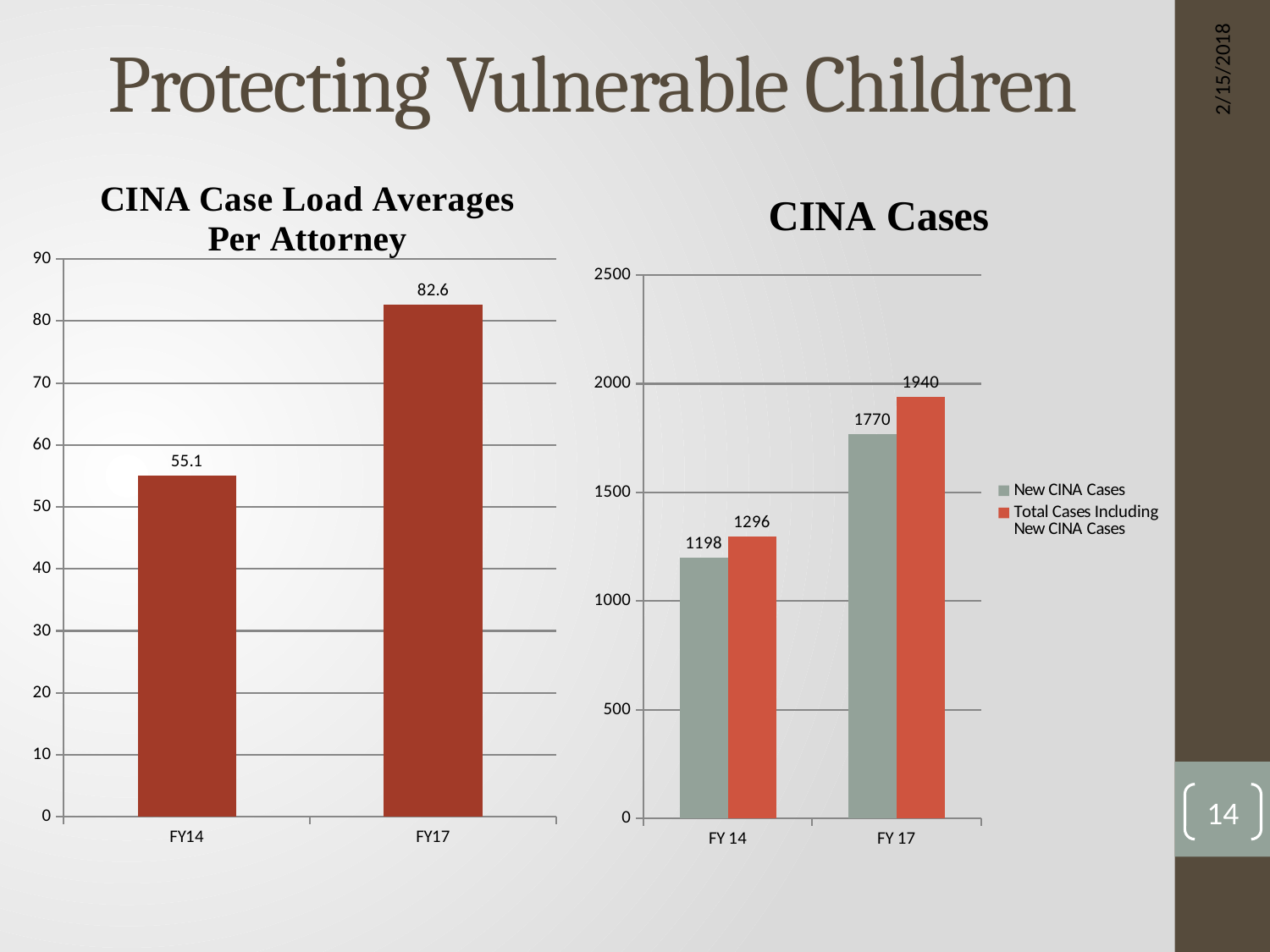
In the 'CINA Cases' chart, what is the value of New CINA Cases for FY 14? 1198 In the 'CINA Cases' chart, what is the value of Total Cases Including New CINA Cases for FY 17? 1940 What kind of chart is the 'CINA Case Load Averages Per Attorney' chart? Bar chart In the 'CINA Case Load Averages Per Attorney' chart, what is the difference between the FY17 and FY14 values? 27.5 In the 'CINA Case Load Averages Per Attorney' chart, what is the value for FY14? 55.1 In the 'CINA Cases' chart, how many series does the legend list? 2 In the 'CINA Cases' chart, which is larger: New CINA Cases in FY 17 or Total Cases Including New CINA Cases in FY 14? New CINA Cases in FY 17 In the 'CINA Cases' chart, what is the difference between New CINA Cases in FY 17 and FY 14? 572 In the 'CINA Case Load Averages Per Attorney' chart, what is the value for FY17? 82.6 In the 'CINA Cases' chart, what is the value of Total Cases Including New CINA Cases for FY 14? 1296 In the 'CINA Case Load Averages Per Attorney' chart, how many categories are shown on the x axis? 2 In the 'CINA Cases' chart, do the values for New CINA Cases rise or fall from FY 14 to FY 17? Rise